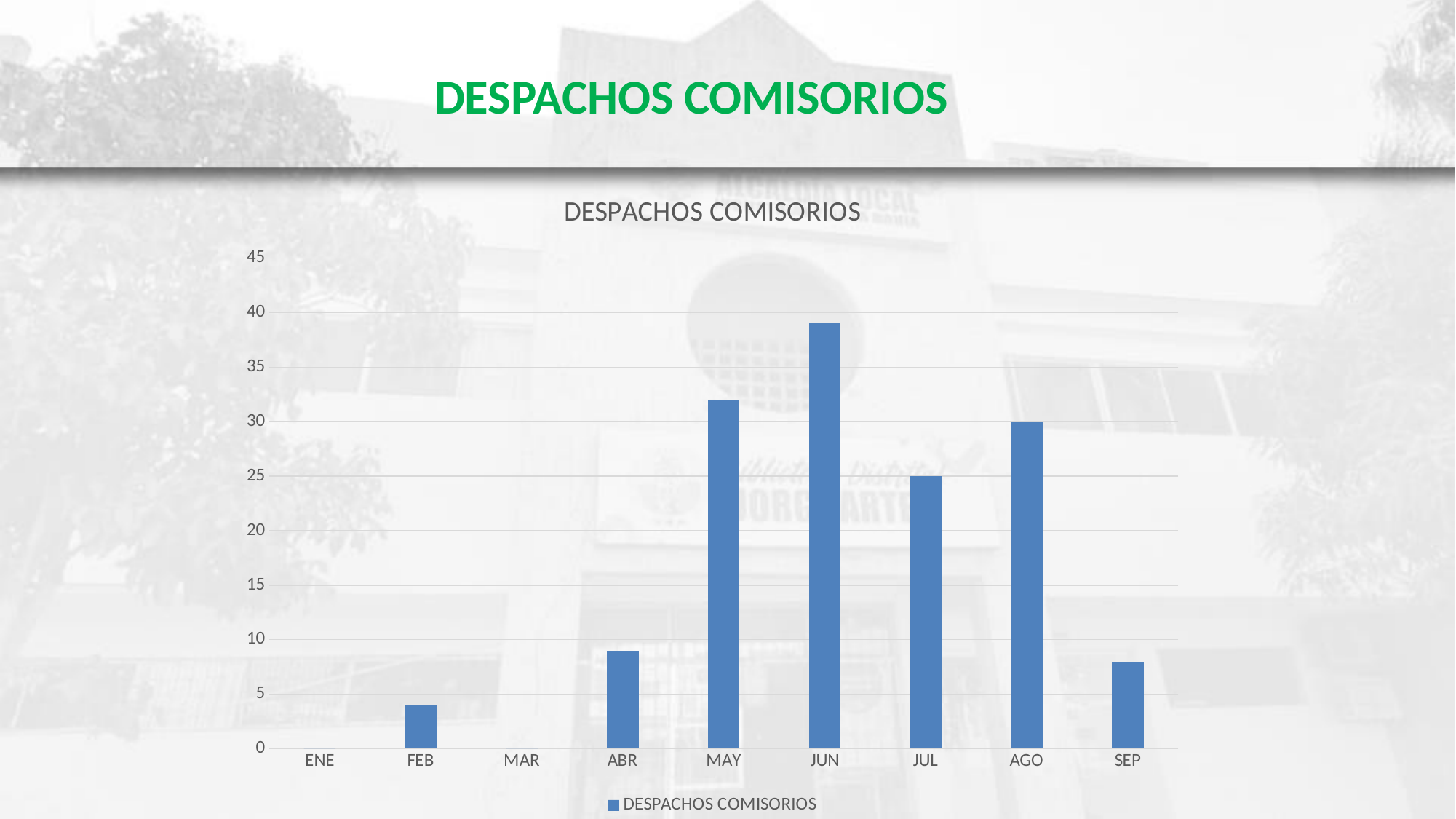
What is the title of the chart? DESPACHOS COMISORIOS Is the value for FEB greater or less than 5? less How many series does the chart legend list? 1 What is the value for JUL? 25 How many months are shown on the x axis of the chart? 9 What is the difference between the values for AGO and JUL? 5 Which month has the highest value in the chart? JUN Do the values rise or fall from ABR to JUN? rise Is the value for JUN greater or less than 35? greater Which is larger, the value for JUL or the value for SEP? JUL What is the value for AGO? 30 What kind of chart is shown on the slide? bar chart